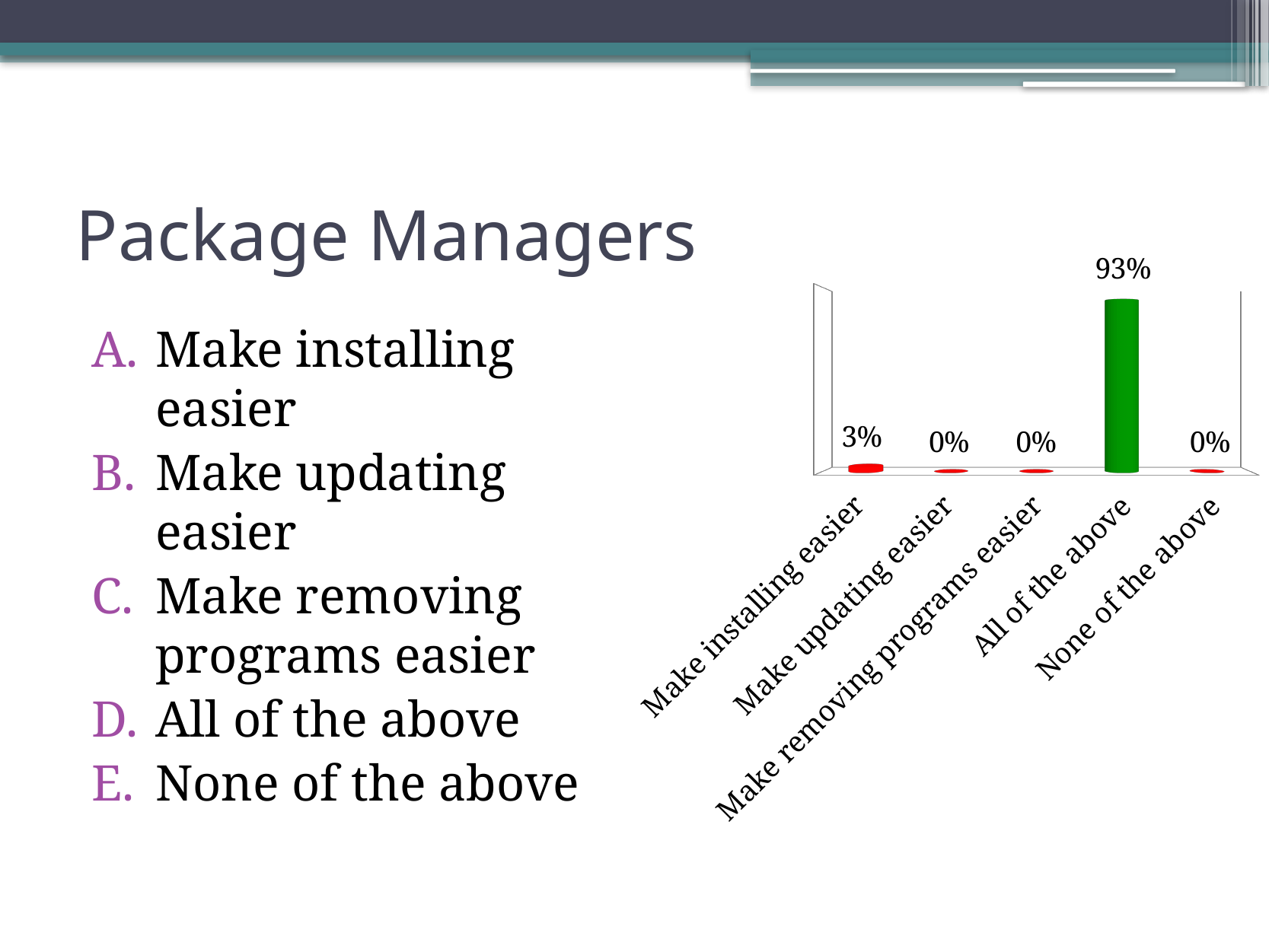
Which category has the highest value? All of the above What is the value for "None of the above"? 0% Which is larger, the value for "Make installing easier" or the value for "Make removing programs easier"? Make installing easier What is the difference between the values for "All of the above" and "Make installing easier"? 90% What colour is the bar for "All of the above"? Green What is the value for "Make installing easier"? 3% What kind of chart is shown on the slide? Bar chart What is the value for "All of the above"? 93% How many categories are shown in the chart? 5 What is the title of the slide containing the chart? Package Managers How many categories have a value of 0%? 3 What is the value for "Make updating easier"? 0%